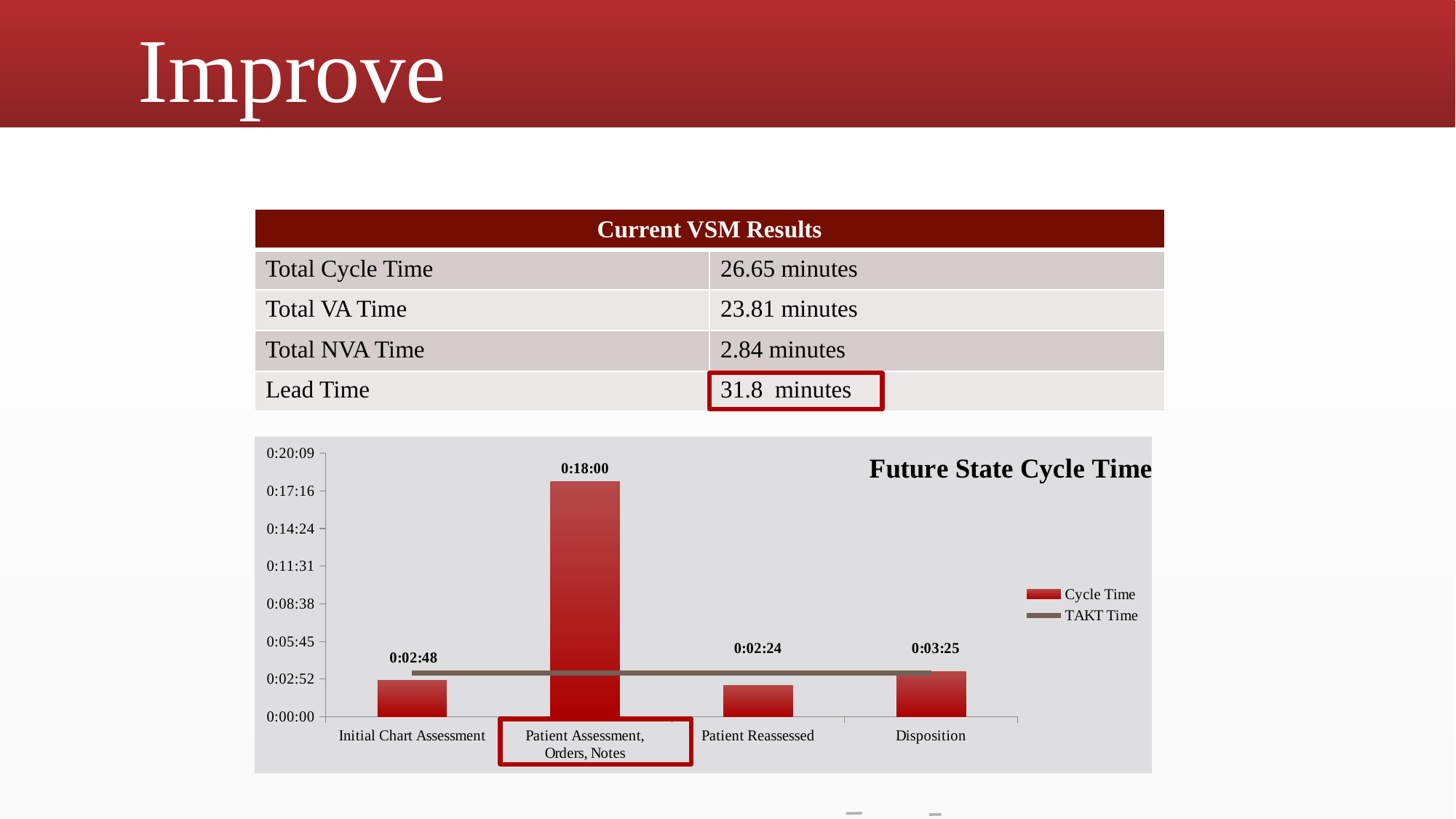
In the Future State Cycle Time chart, is the Cycle Time for Patient Assessment, Orders, Notes greater or less than 0:14:24? greater How many categories are shown on the x axis of the Future State Cycle Time chart? 4 What is the Cycle Time value for Initial Chart Assessment in the Future State Cycle Time chart? 0:02:48 In the Future State Cycle Time chart, which has a larger Cycle Time: Initial Chart Assessment or Disposition? Disposition Which category has the lowest Cycle Time in the Future State Cycle Time chart? Patient Reassessed What type of chart is used to show Cycle Time in the Future State Cycle Time chart? Bar chart What is the Cycle Time value for Patient Reassessed in the Future State Cycle Time chart? 0:02:24 What is the Cycle Time value for Disposition in the Future State Cycle Time chart? 0:03:25 How many series does the legend of the Future State Cycle Time chart list? 2 Which category has the highest Cycle Time in the Future State Cycle Time chart? Patient Assessment, Orders, Notes In the Future State Cycle Time chart, what is the difference between the Cycle Time for Patient Assessment, Orders, Notes and Initial Chart Assessment? 0:15:12 What is the Cycle Time value for Patient Assessment, Orders, Notes in the Future State Cycle Time chart? 0:18:00